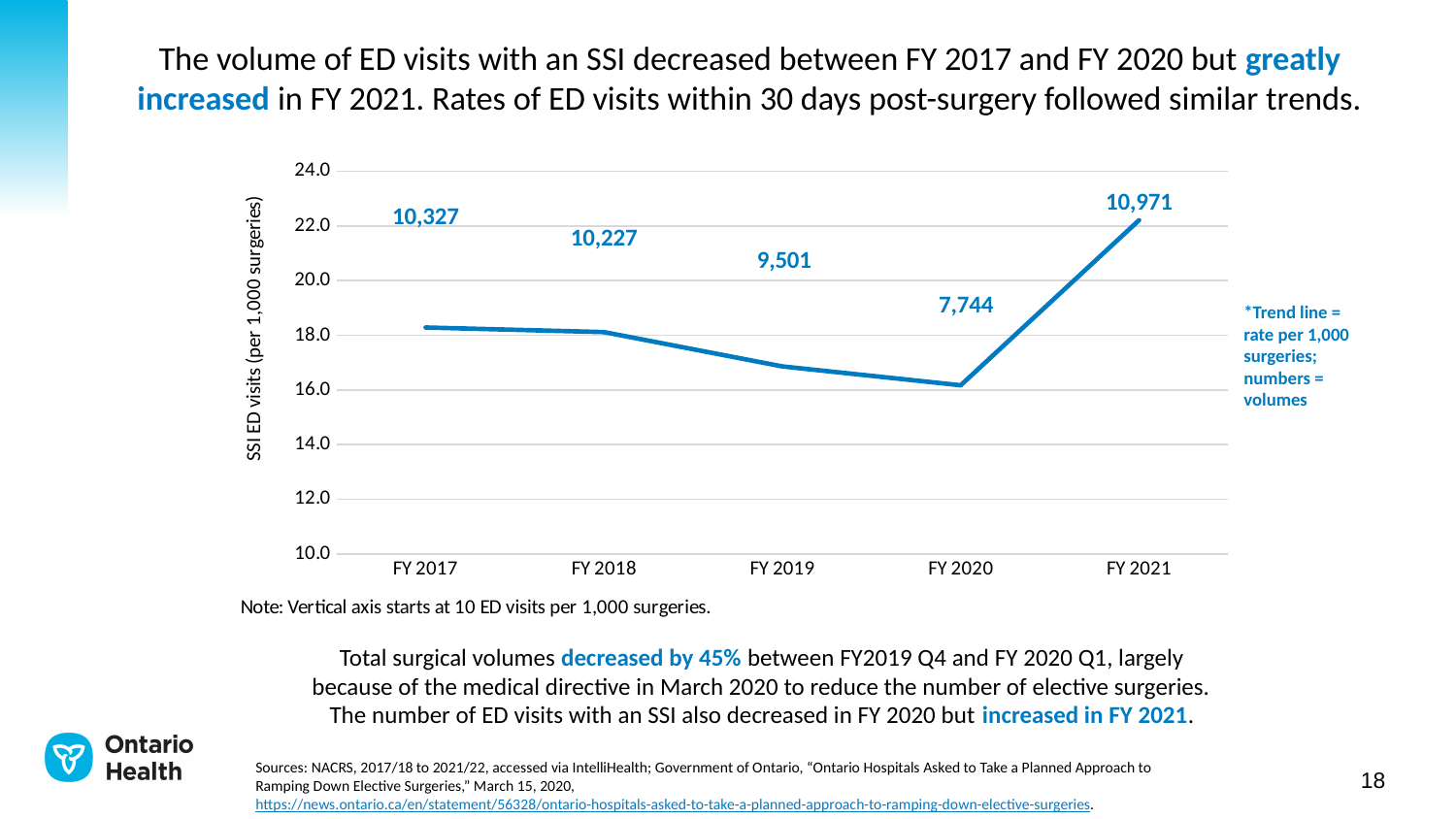
What volume label is shown for FY 2020? 7,744 Which fiscal year has the highest labelled volume of SSI ED visits? FY 2021 What kind of chart is shown on the slide? Line chart What is the difference between the labelled volumes for FY 2021 and FY 2020? 3,227 Does the plotted rate rise or fall from FY 2017 to FY 2020? Fall What volume label is shown for FY 2017? 10,327 Which has the larger labelled volume, FY 2018 or FY 2019? FY 2018 Is the plotted rate for FY 2020 greater or less than 18.0? less Which fiscal year has the lowest labelled volume of SSI ED visits? FY 2020 Is the plotted rate for FY 2021 greater or less than 20.0? greater What volume label is shown for FY 2021? 10,971 How many fiscal years are plotted on the x axis? 5